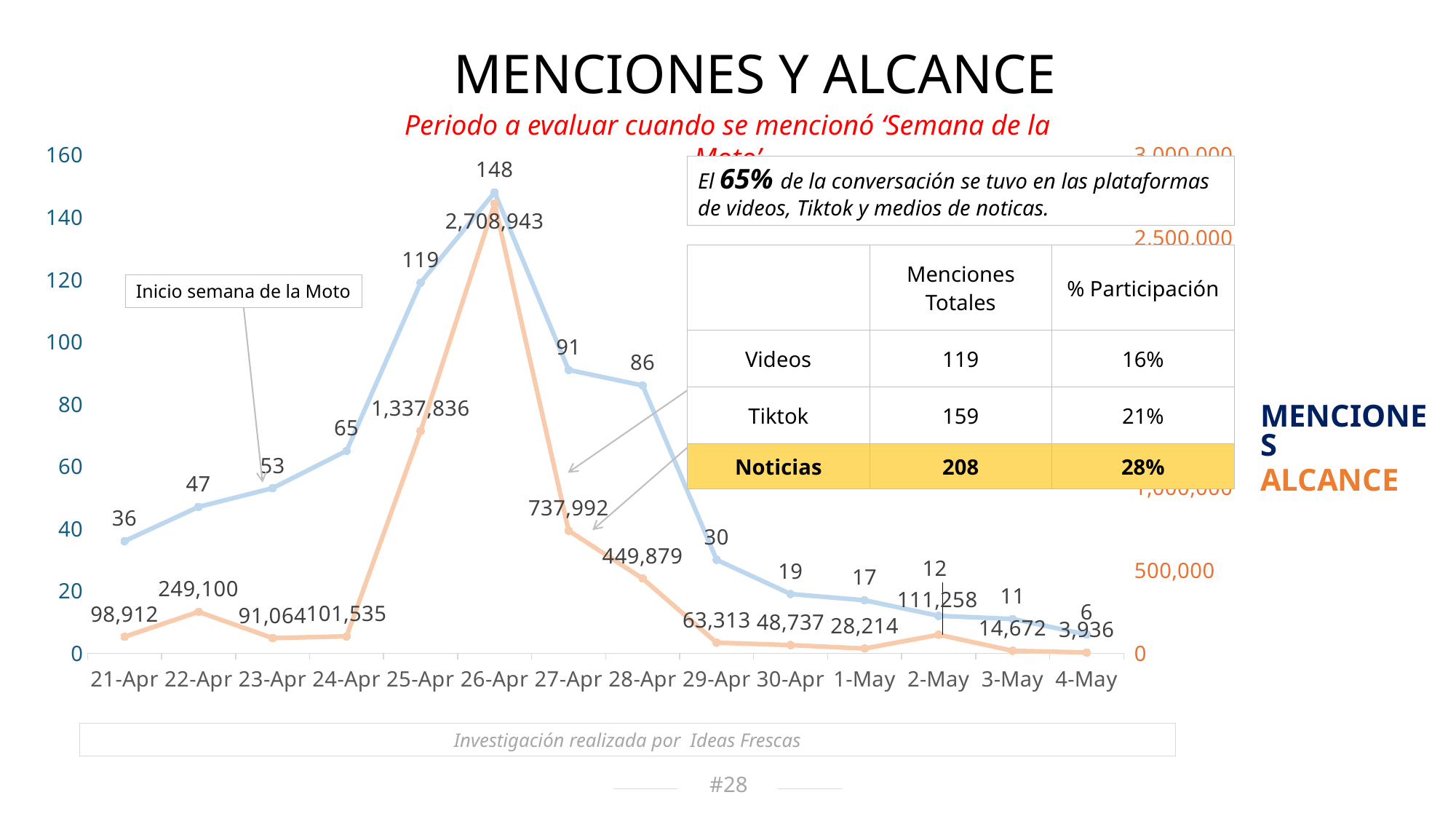
Do the Menciones values rise or fall from 26-Apr to 4-May? fall What is the difference between the Menciones values on 26-Apr and 25-Apr? 29 On which date does the Menciones series reach its highest value? 26-Apr On which date is the Alcance value lowest? 4-May Which series is drawn in orange on the chart? ALCANCE What is the Alcance value on 25-Apr? 1,337,836 What is the Menciones value on 26-Apr? 148 Which date has the larger Alcance value, 22-Apr or 23-Apr? 22-Apr What is the difference between the Alcance values on 27-Apr and 28-Apr? 288,113 How many dates are plotted along the x axis of the chart? 14 What type of chart is shown on the slide? line chart What is the Alcance value on 2-May? 111,258